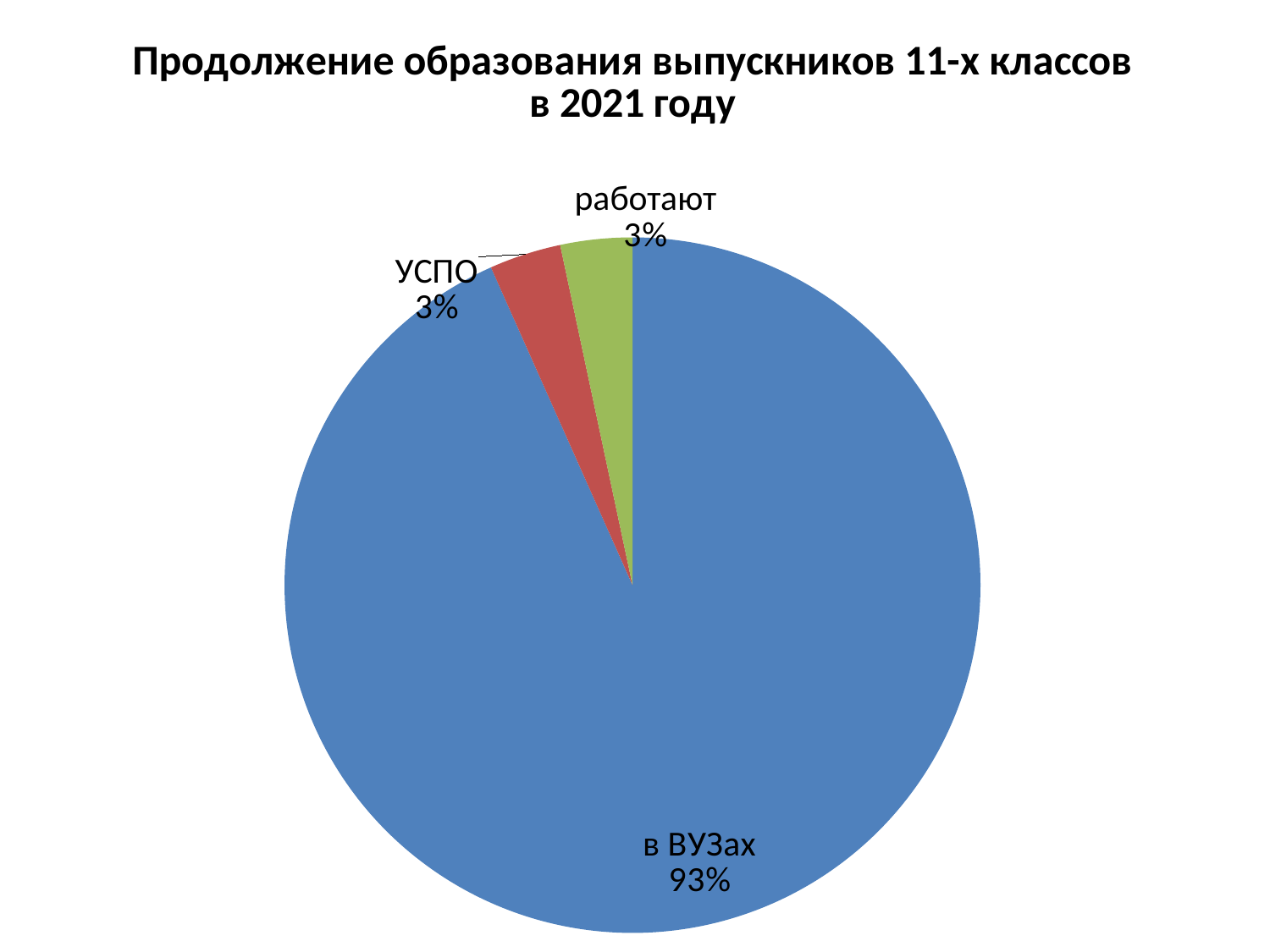
What is the difference in percentage points between "в ВУЗах" and "УСПО"? 90 What is the title of the chart? Продолжение образования выпускников 11-х классов в 2021 году Which is larger, the slice for "в ВУЗах" or the slice for "работают"? в ВУЗах What colour is the slice for "работают"? green What kind of chart is shown on the slide? pie chart How many slices does the pie chart have? 3 What share of the pie does the slice "в ВУЗах" represent? 93% What is the value shown for "УСПО"? 3% What is the value shown for "работают"? 3% Which category has the largest slice of the pie? в ВУЗах